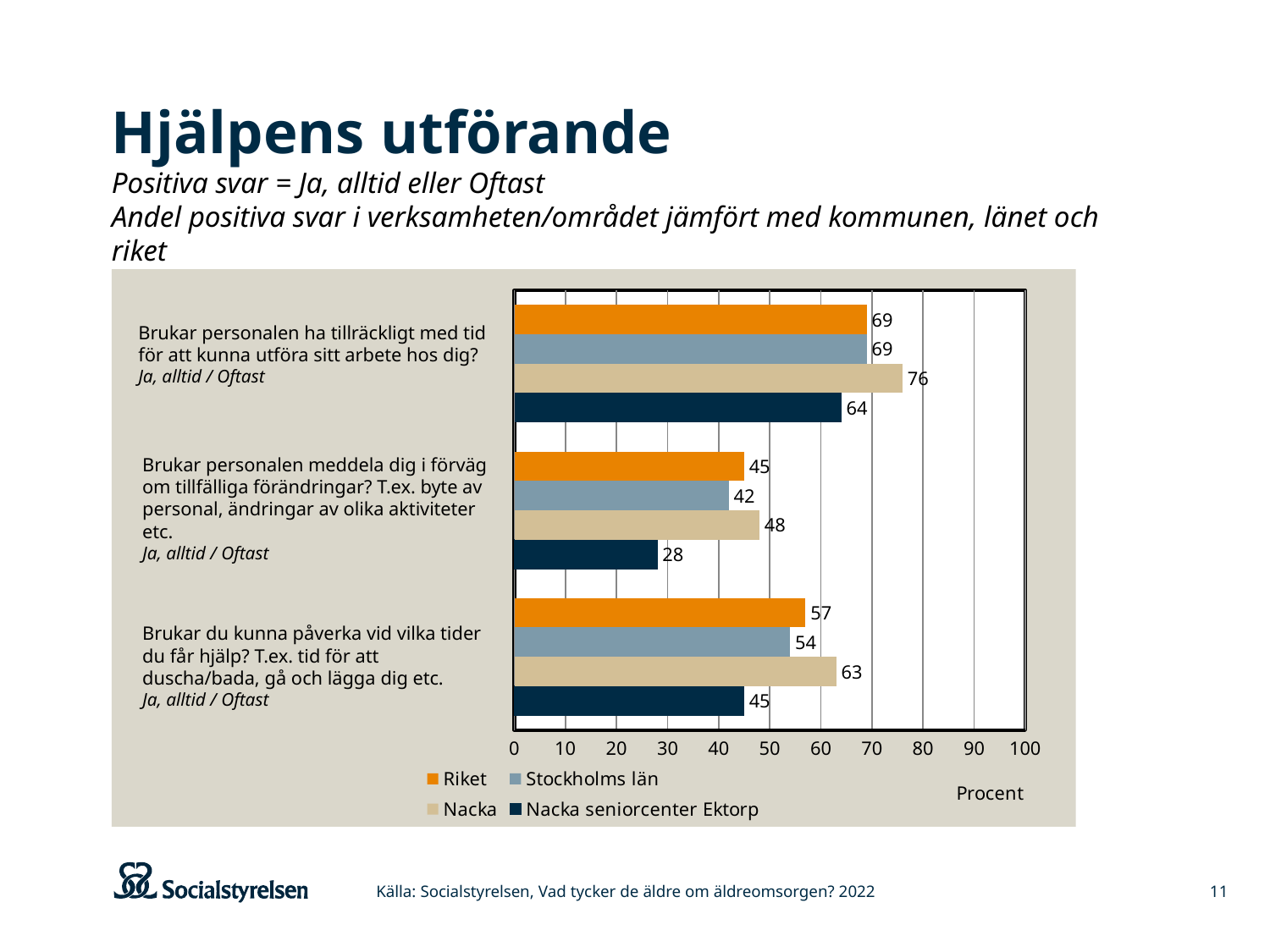
How many series does the legend list? 4 What is the value for Nacka for the question "Brukar personalen ha tillräckligt med tid för att kunna utföra sitt arbete hos dig?"? 76 Which series has the lowest value for the question "Brukar personalen meddela dig i förväg om tillfälliga förändringar?"? Nacka seniorcenter Ektorp Which series has the highest value for the question "Brukar du kunna påverka vid vilka tider du får hjälp?"? Nacka What is the difference between Riket and Nacka seniorcenter Ektorp for the question "Brukar personalen meddela dig i förväg om tillfälliga förändringar?"? 17 What is the difference between Nacka and Nacka seniorcenter Ektorp for the question "Brukar personalen ha tillräckligt med tid för att kunna utföra sitt arbete hos dig?"? 12 Which is larger for the question "Brukar du kunna påverka vid vilka tider du får hjälp?": Riket or Nacka seniorcenter Ektorp? Riket What kind of chart is shown on the slide? Bar chart What is the value for Nacka seniorcenter Ektorp for the question "Brukar personalen meddela dig i förväg om tillfälliga förändringar?"? 28 What is the value for Stockholms län for the question "Brukar du kunna påverka vid vilka tider du får hjälp?"? 54 How many question categories are shown on the chart? 3 What is the label of the horizontal axis? Procent